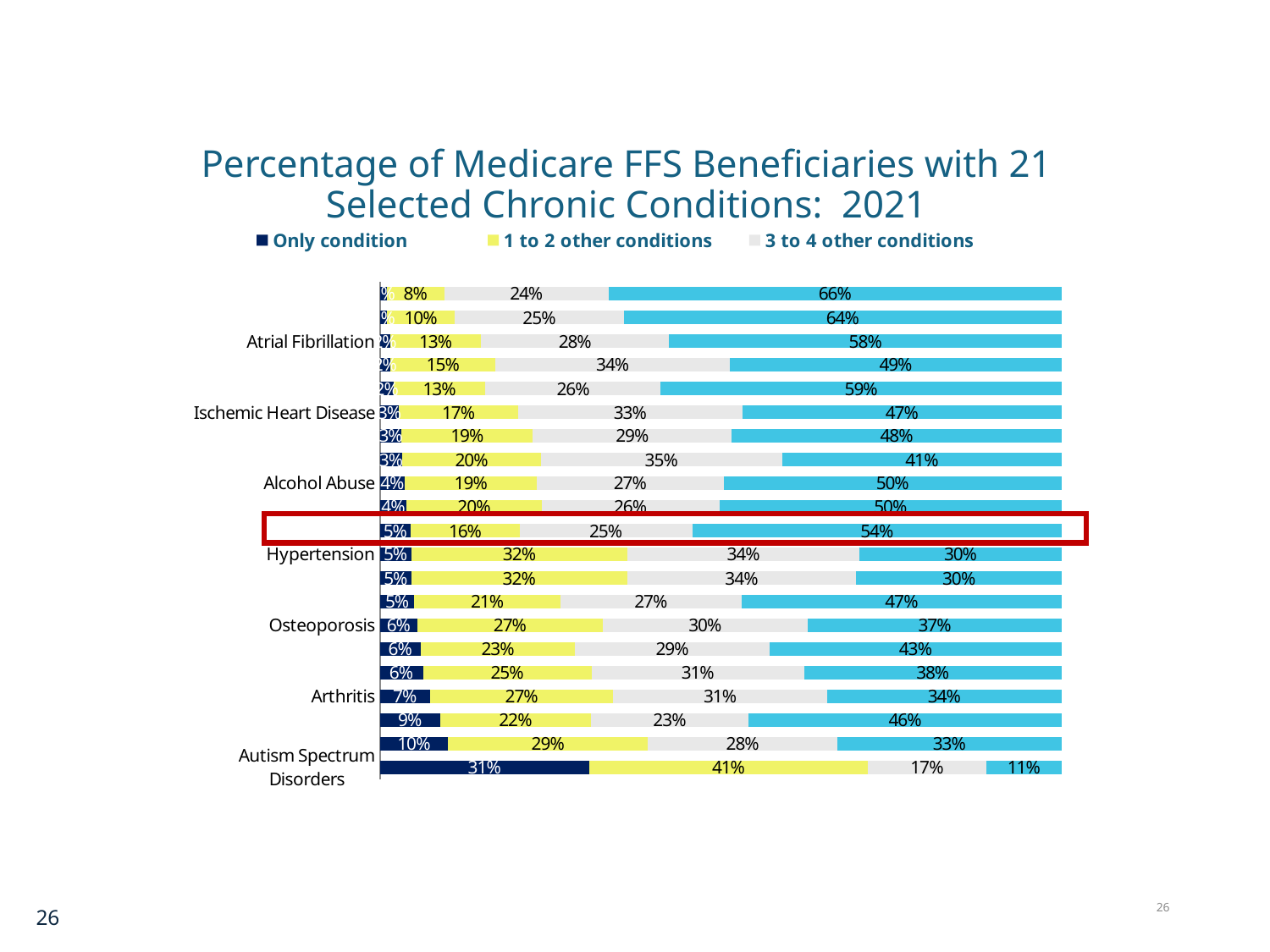
Which is larger, the '1 to 2 other conditions' value for Alcohol Abuse or for Hypertension? Hypertension Among the labeled conditions, which has the highest 'Only condition' value? Autism Spectrum Disorders What is the 'Only condition' value for Autism Spectrum Disorders? 31% What is the 'Only condition' value for Arthritis? 7% What is the '3 to 4 other conditions' value for Ischemic Heart Disease? 33% How many condition bars are plotted in the chart? 21 What type of chart is shown on the slide? Stacked bar chart What is the '1 to 2 other conditions' value for Osteoporosis? 27% What is the difference between the '1 to 2 other conditions' values for Autism Spectrum Disorders (41%) and Ischemic Heart Disease (17%)? 24% What is the title of the chart? Percentage of Medicare FFS Beneficiaries with 21 Selected Chronic Conditions: 2021 Which legend entry is shown in dark blue? Only condition What is the '1 to 2 other conditions' value for Hypertension? 32%